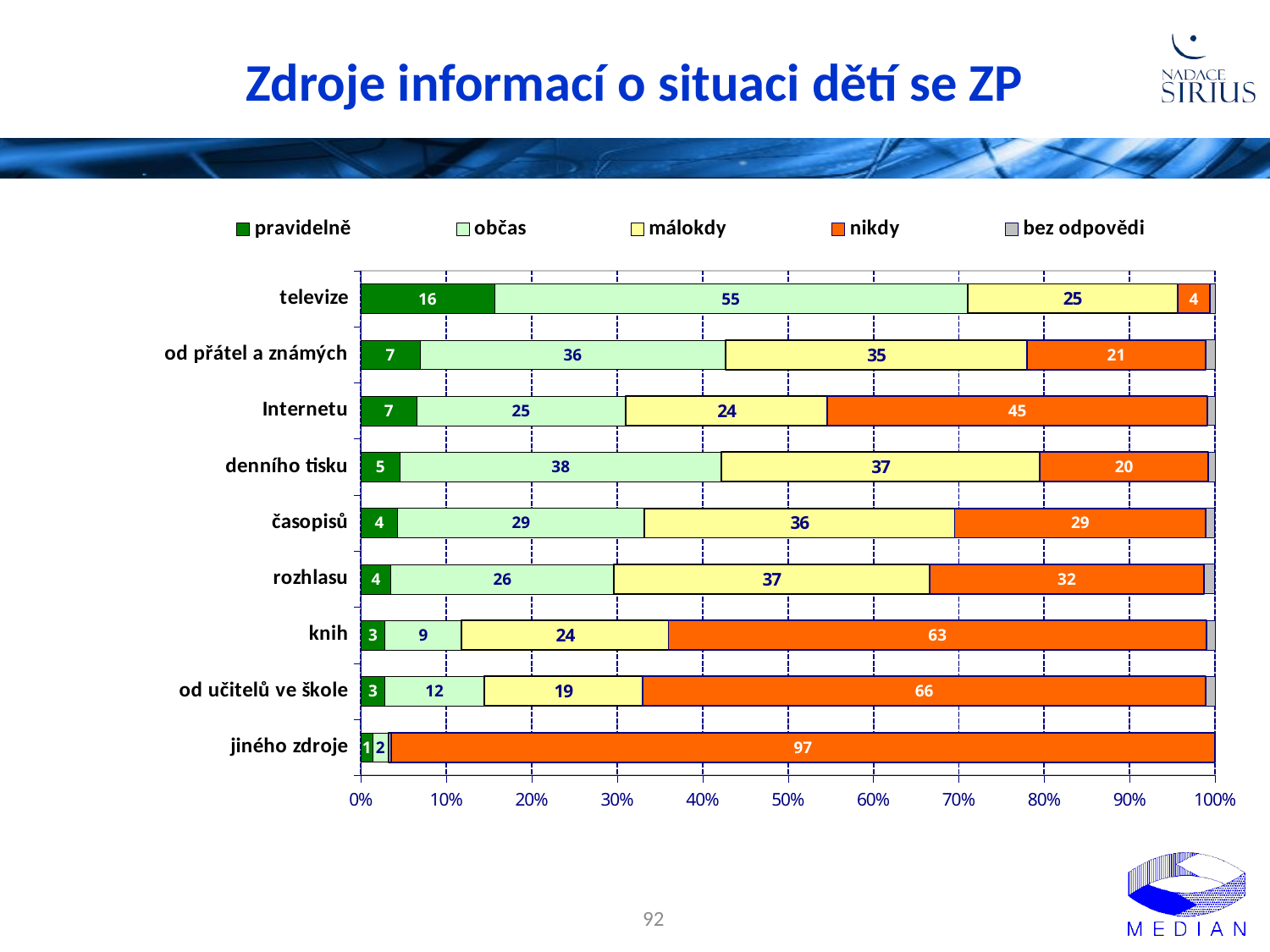
How many series does the legend list? 5 Which category has the highest value for "pravidelně"? televize What kind of chart is shown on the slide? stacked bar chart Which category has the lowest value for "nikdy"? televize What is the value for "nikdy" for knih? 63 Which has a larger "občas" value: denního tisku or časopisů? denního tisku How many categories are shown on the chart? 9 What is the difference between the "nikdy" value for Internetu and the "nikdy" value for od přátel a známých? 24 Which category has the highest value for "nikdy"? jiného zdroje What is the value for "málokdy" for rozhlasu? 37 What is the value for "občas" for televize? 55 What is the title of the slide? Zdroje informací o situaci dětí se ZP